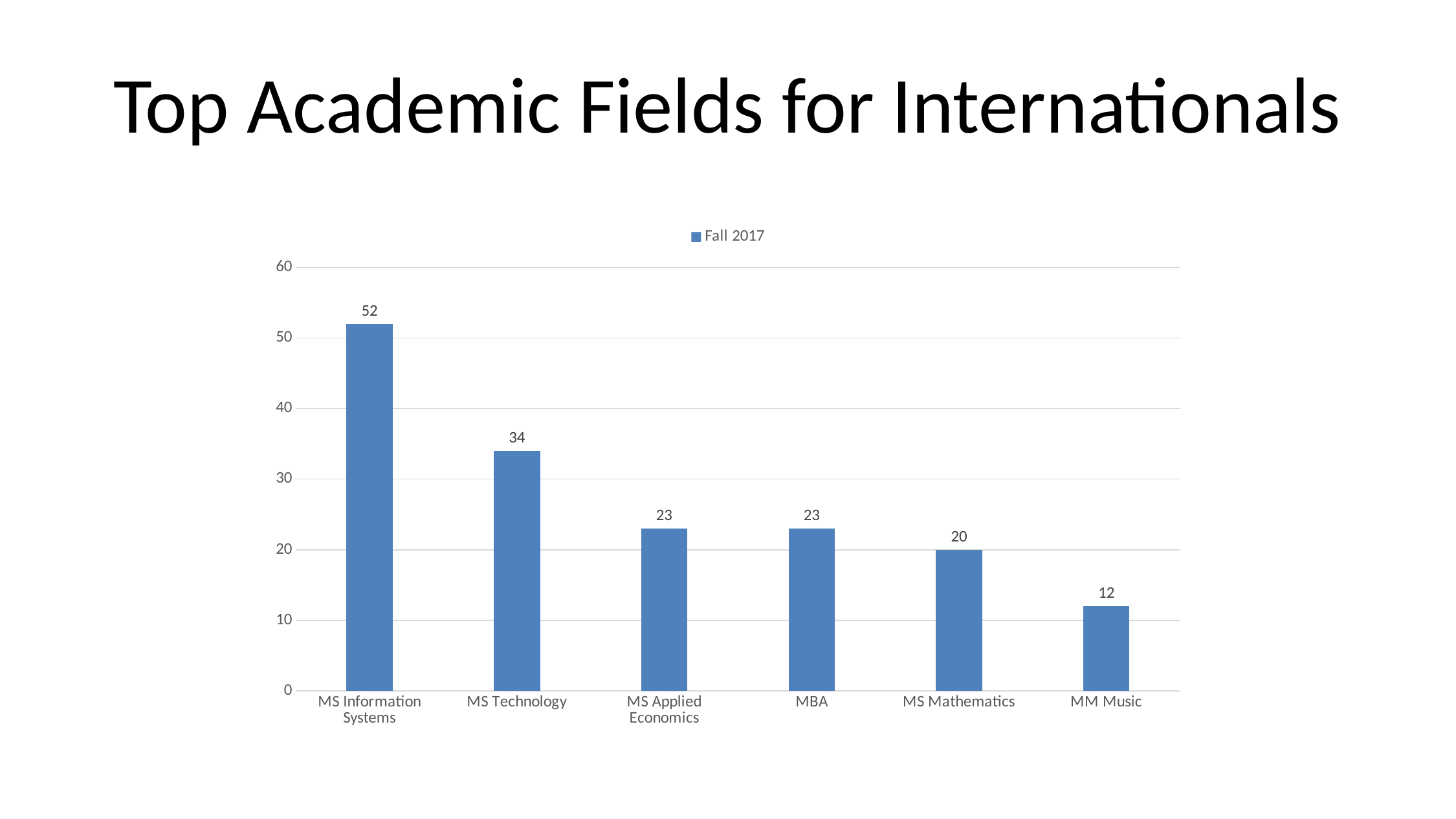
How many academic fields are shown on the chart? 6 Which academic field has the highest value? MS Information Systems What is the value for MS Information Systems? 52 What is the value for MS Technology? 34 What is the value for MS Mathematics? 20 What is the difference between the values for MS Mathematics and MM Music? 8 What is the difference between the values for MS Information Systems and MS Technology? 18 What kind of chart is shown on the slide? Bar chart What series does the legend list? Fall 2017 Which academic field has the lowest value? MM Music Which is larger, the value for MS Technology or the value for MBA? MS Technology What is the value for MM Music? 12